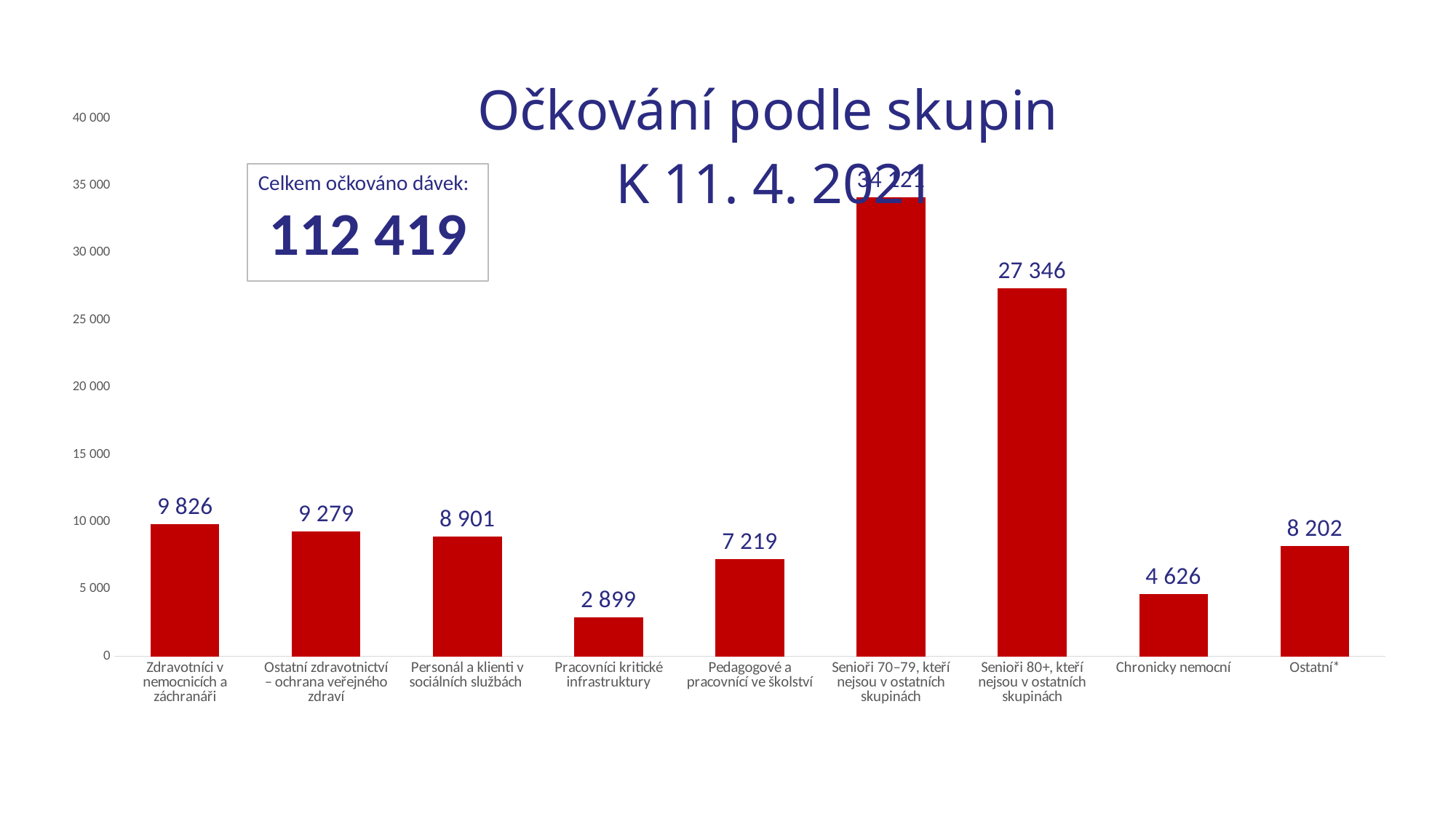
What total number of doses is shown in the text box on the slide (Celkem očkováno dávek)? 112 419 Which category has the highest value? Senioři 70–79, kteří nejsou v ostatních skupinách What is the value for Chronicky nemocní? 4 626 What is the value for Zdravotníci v nemocnicích a záchranáři? 9 826 What is the difference between the values for Zdravotníci v nemocnicích a záchranáři and Ostatní zdravotnictví – ochrana veřejného zdraví? 547 Is the value for Senioři 70–79, kteří nejsou v ostatních skupinách greater or less than 30 000? greater What is the value for Senioři 80+, kteří nejsou v ostatních skupinách? 27 346 How many categories are shown on the x axis? 9 Which is larger, the value for Pedagogové a pracovníci ve školství or the value for Ostatní*? Ostatní* What is the value for Pracovníci kritické infrastruktury? 2 899 Which category has the lowest value? Pracovníci kritické infrastruktury What kind of chart is shown on the slide? bar chart